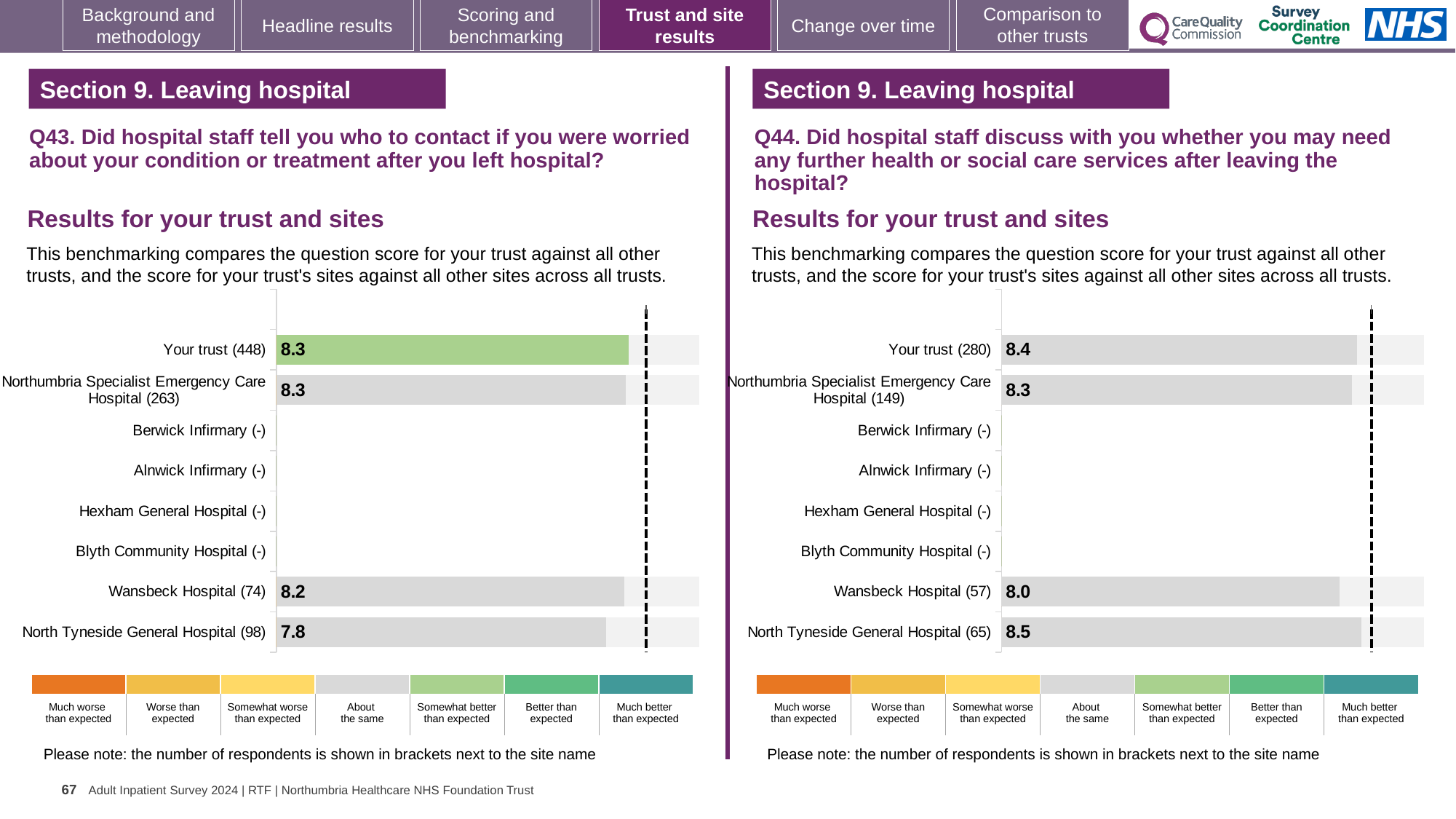
In the Q43 chart on the left, which site with a score has the lowest score? North Tyneside General Hospital How many rows (trust and sites) are listed in the Q43 chart on the left? 8 In the Q43 chart on the left, what is the score for Wansbeck Hospital? 8.2 In the Q44 chart on the right, what is the difference between the scores for North Tyneside General Hospital and Wansbeck Hospital? 0.5 In the Q44 chart on the right, which is larger: the score for Northumbria Specialist Emergency Care Hospital or the score for Wansbeck Hospital? Northumbria Specialist Emergency Care Hospital In the Q44 chart on the right, what is the score for Your trust? 8.4 In the Q44 chart on the right, which site has the highest score? North Tyneside General Hospital In the Q43 chart on the left, what is the score for North Tyneside General Hospital? 7.8 In the Q43 chart on the left, what is the difference between the scores for Wansbeck Hospital and North Tyneside General Hospital? 0.4 What kind of chart is used in the Q44 chart on the right? Bar chart In the Q43 chart on the left, what is the score for Your trust? 8.3 In the Q44 chart on the right, what is the score for Wansbeck Hospital? 8.0